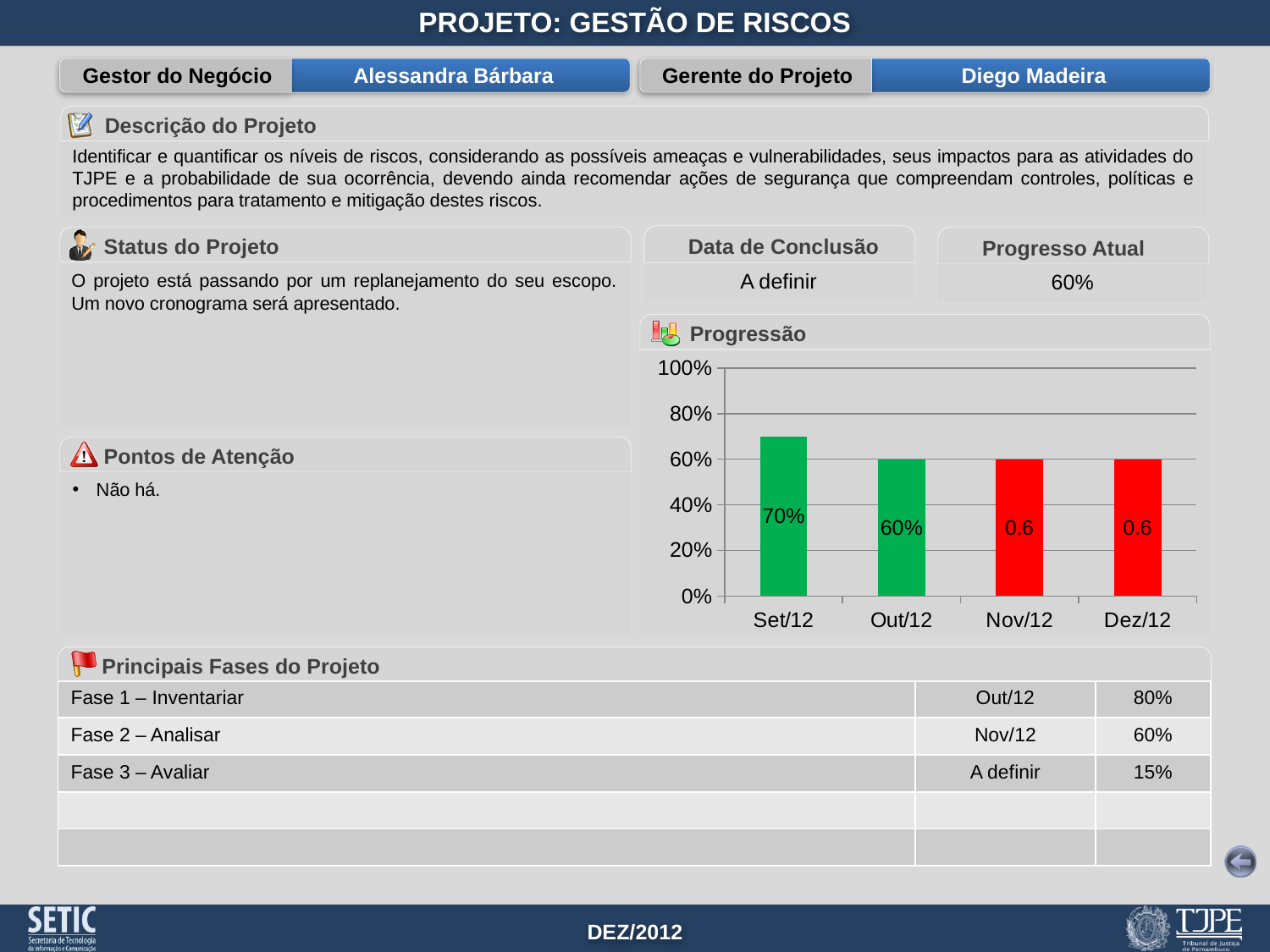
What colour are the Nov/12 and Dez/12 bars in the Progressão chart? red Is the value for Set/12 in the Progressão chart greater or less than 60%? greater What kind of chart is the Progressão chart? bar chart Which is larger in the Progressão chart, the value for Set/12 or the value for Out/12? Set/12 What is the difference between the Set/12 and Out/12 values in the Progressão chart? 10% What data label is printed on the Dez/12 bar in the Progressão chart? 0.6 What is the value shown for Set/12 in the Progressão chart? 70% What data label is printed on the Nov/12 bar in the Progressão chart? 0.6 What is the value shown for Out/12 in the Progressão chart? 60% Which month has the highest bar in the Progressão chart? Set/12 Does the value fall or rise from Set/12 to Out/12 in the Progressão chart? fall How many months are shown on the x axis of the Progressão chart? 4